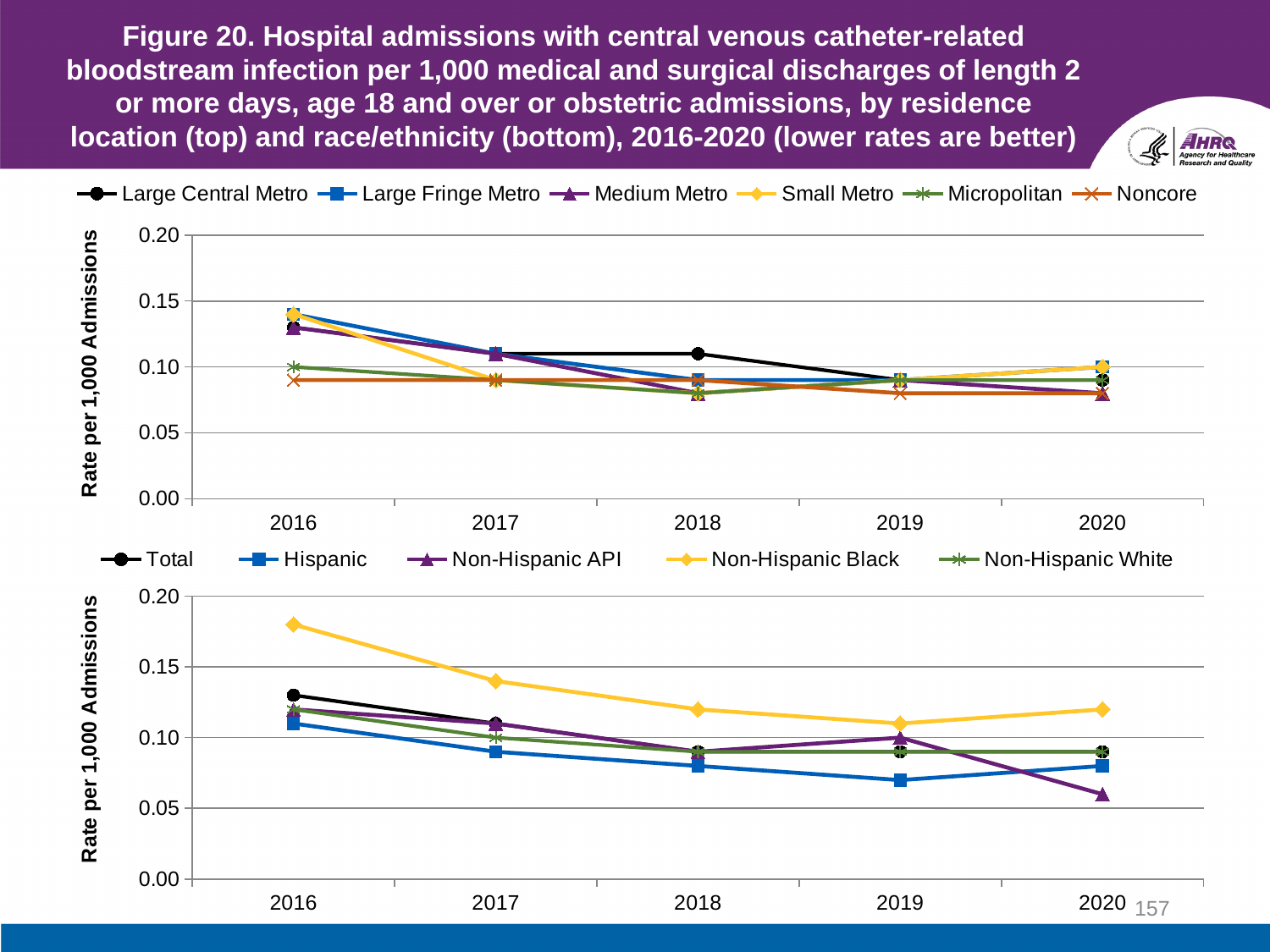
How many series does the legend of the top chart (residence location) list? 6 In the bottom chart (race/ethnicity), which group has the lowest rate in 2020? Non-Hispanic API What type of chart is the top chart on the slide? Line chart In the top chart (residence location), is the value for Medium Metro in 2018 greater or less than 0.10? less In the bottom chart (race/ethnicity), is the value for Non-Hispanic Black in 2016 greater or less than 0.15? greater In the bottom chart (race/ethnicity), which is larger in 2016: the rate for Non-Hispanic Black or the rate for Hispanic? Non-Hispanic Black In the top chart (residence location), is the value for Large Central Metro in 2016 greater or less than 0.15? less In the bottom chart (race/ethnicity), does the rate for Hispanic rise or fall from 2016 to 2019? Fall How many years are shown on the x axis of the bottom chart? 5 In the bottom chart (race/ethnicity), which group has the highest rate in 2016? Non-Hispanic Black How many series does the legend of the bottom chart (race/ethnicity) list? 5